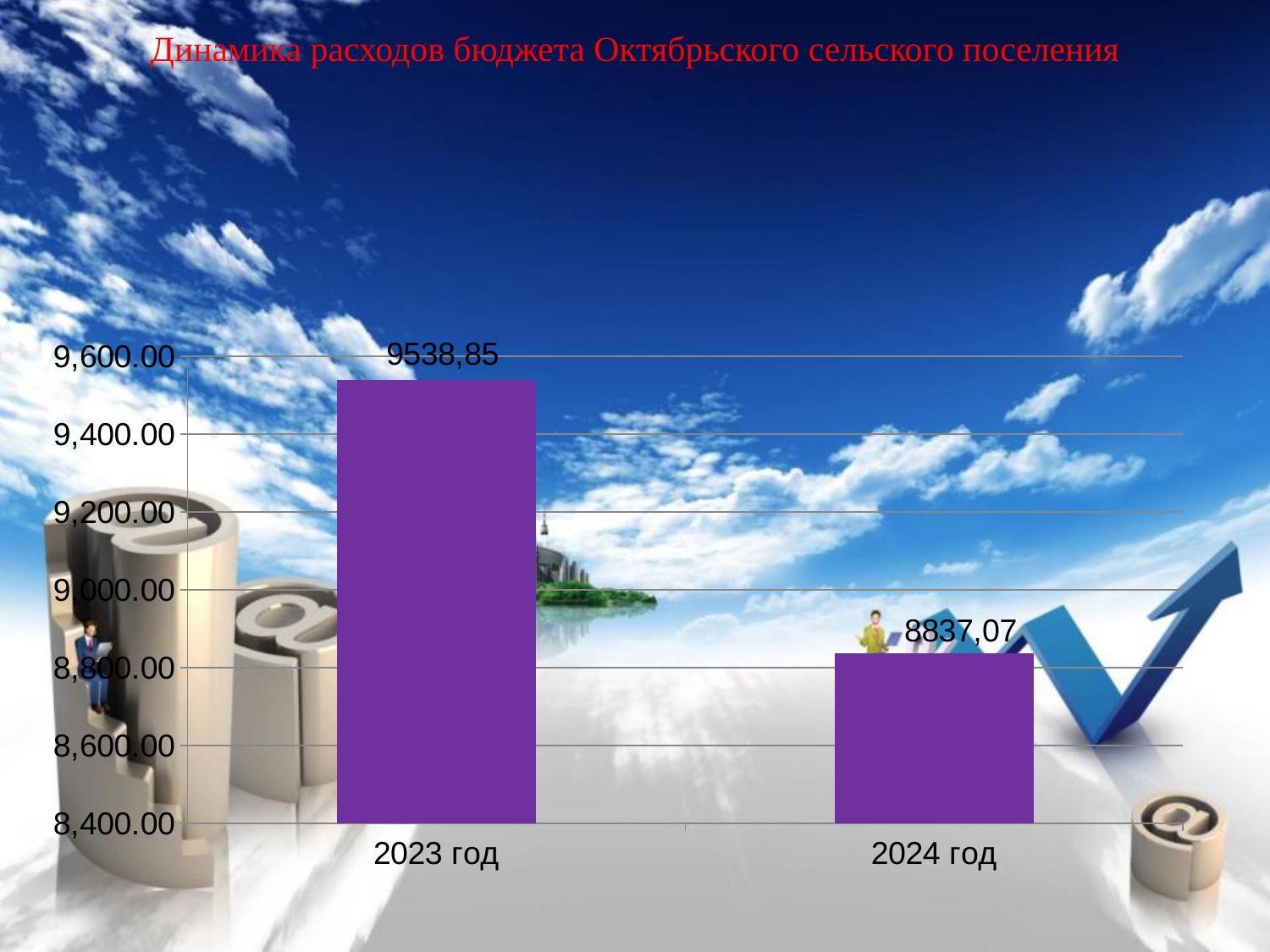
Which is larger, the value for 2023 год or the value for 2024 год? 2023 год What is the value for 2023 год? 9538,85 How many categories are shown on the x axis? 2 Do the values rise or fall from 2023 год to 2024 год? fall What is the title of the slide? Динамика расходов бюджета Октябрьского сельского поселения Is the value for 2024 год greater or less than 9,000.00? less Which year has the lowest value? 2024 год What is the difference between the values for 2023 год and 2024 год? 701,78 What is the value for 2024 год? 8837,07 What kind of chart is shown on the slide? bar chart Which year has the highest value? 2023 год Is the value for 2023 год greater or less than 9,400.00? greater